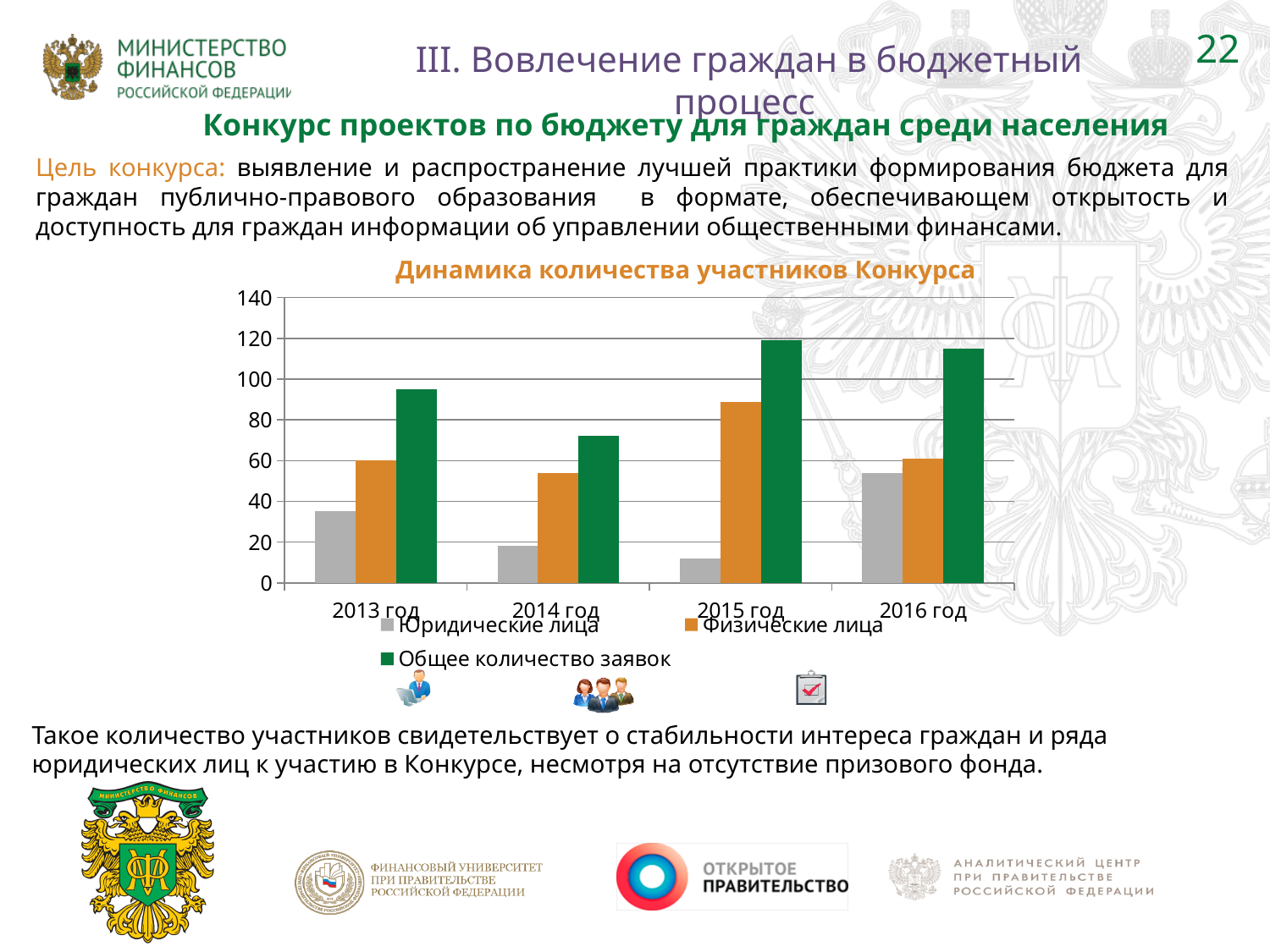
Is the value for "Юридические лица" in 2014 год greater or less than 20? less Is the value for "Общее количество заявок" in 2013 год greater or less than 80? greater What colour are the bars for "Общее количество заявок" in the chart? green What kind of chart is shown under the title "Динамика количества участников Конкурса"? bar chart Which year has the highest value for "Общее количество заявок"? 2015 год Which is larger in 2016 год: the value for "Юридические лица" or the value for "Общее количество заявок"? Общее количество заявок Is the value for "Физические лица" in 2015 год greater or less than 80? greater How many years are shown on the x axis of the chart? 4 Which year has the lowest value for "Общее количество заявок"? 2014 год Which year has the highest value for "Физические лица"? 2015 год How many series does the legend of the chart list? 3 Which year has the lowest value for "Юридические лица"? 2015 год